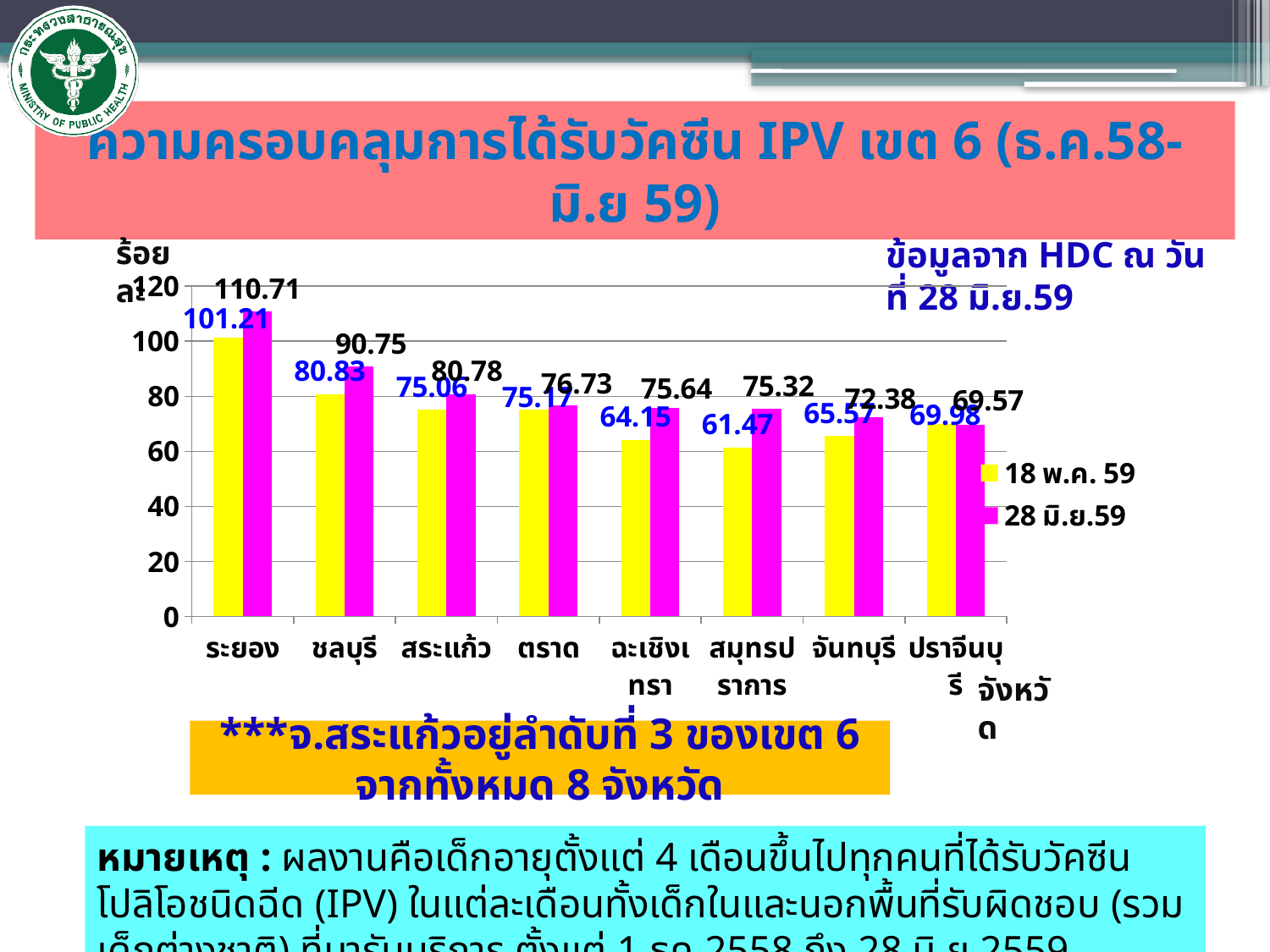
What is the value for สมุทรปราการ in the 28 มิ.ย.59 series? 75.32 Is the 28 มิ.ย.59 value for จันทบุรี greater or less than 80? less What kind of chart is shown on the slide? bar chart Which province has the lowest value in the 18 พ.ค. 59 series? สมุทรปราการ How many series does the legend list? 2 Which province has the highest value in the 28 มิ.ย.59 series? ระยอง What is the difference between the 28 มิ.ย.59 and 18 พ.ค. 59 values for ฉะเชิงเทรา? 11.49 Which is larger for ปราจีนบุรี: the 18 พ.ค. 59 value or the 28 มิ.ย.59 value? 18 พ.ค. 59 Which colour represents the 28 มิ.ย.59 series? magenta What is the value for ชลบุรี in the 18 พ.ค. 59 series? 80.83 What is the value for ระยอง in the 28 มิ.ย.59 series? 110.71 How many provinces are shown on the x axis? 8